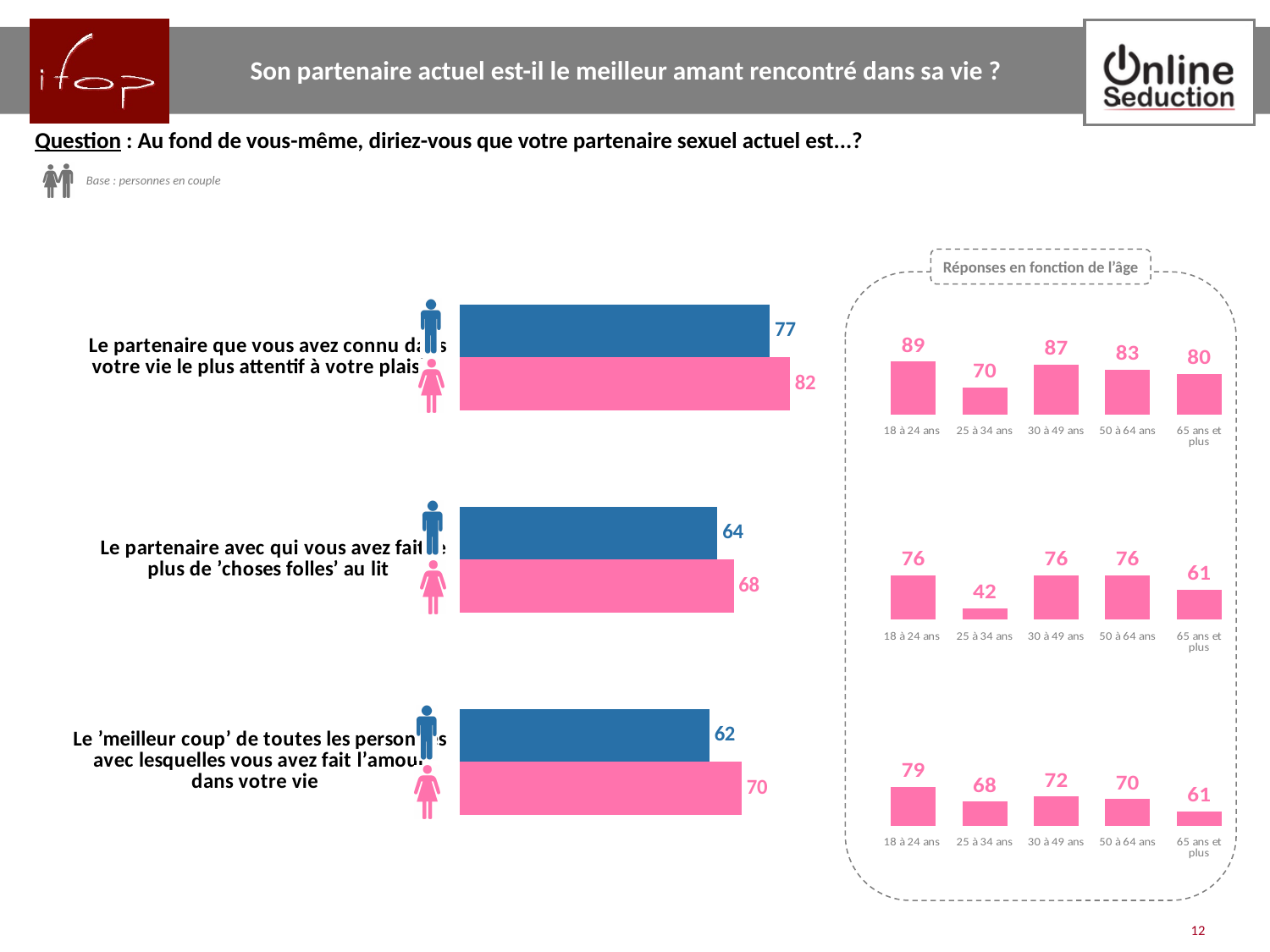
How many age groups are shown in each age-breakdown chart on the right? 5 In the middle age-breakdown chart on the right, which age group has the lowest value? 25 à 34 ans In the main chart on the left, which is larger for 'Le partenaire que vous avez connu dans votre vie le plus attentif à votre plaisir': the blue bar or the pink bar? the pink bar In the middle age-breakdown chart on the right, what is the value for '65 ans et plus'? 61 In the bottom age-breakdown chart on the right, what is the value for '30 à 49 ans'? 72 In the main chart on the left, what value is shown on the blue bar for 'Le partenaire que vous avez connu dans votre vie le plus attentif à votre plaisir'? 77 In the main chart on the left, what is the difference between the pink bar and the blue bar for 'Le 'meilleur coup' de toutes les personnes avec lesquelles vous avez fait l'amour dans votre vie'? 8 In the main chart on the left, how many statements (categories) are plotted? 3 In the top age-breakdown chart on the right, what is the difference between the values for '18 à 24 ans' and '25 à 34 ans'? 19 In the top age-breakdown chart on the right ('Réponses en fonction de l'âge'), which age group has the highest value? 18 à 24 ans What type of chart is the main chart on the left of the slide? bar chart In the main chart on the left, what value is shown on the pink bar for 'Le partenaire avec qui vous avez fait le plus de 'choses folles' au lit'? 68